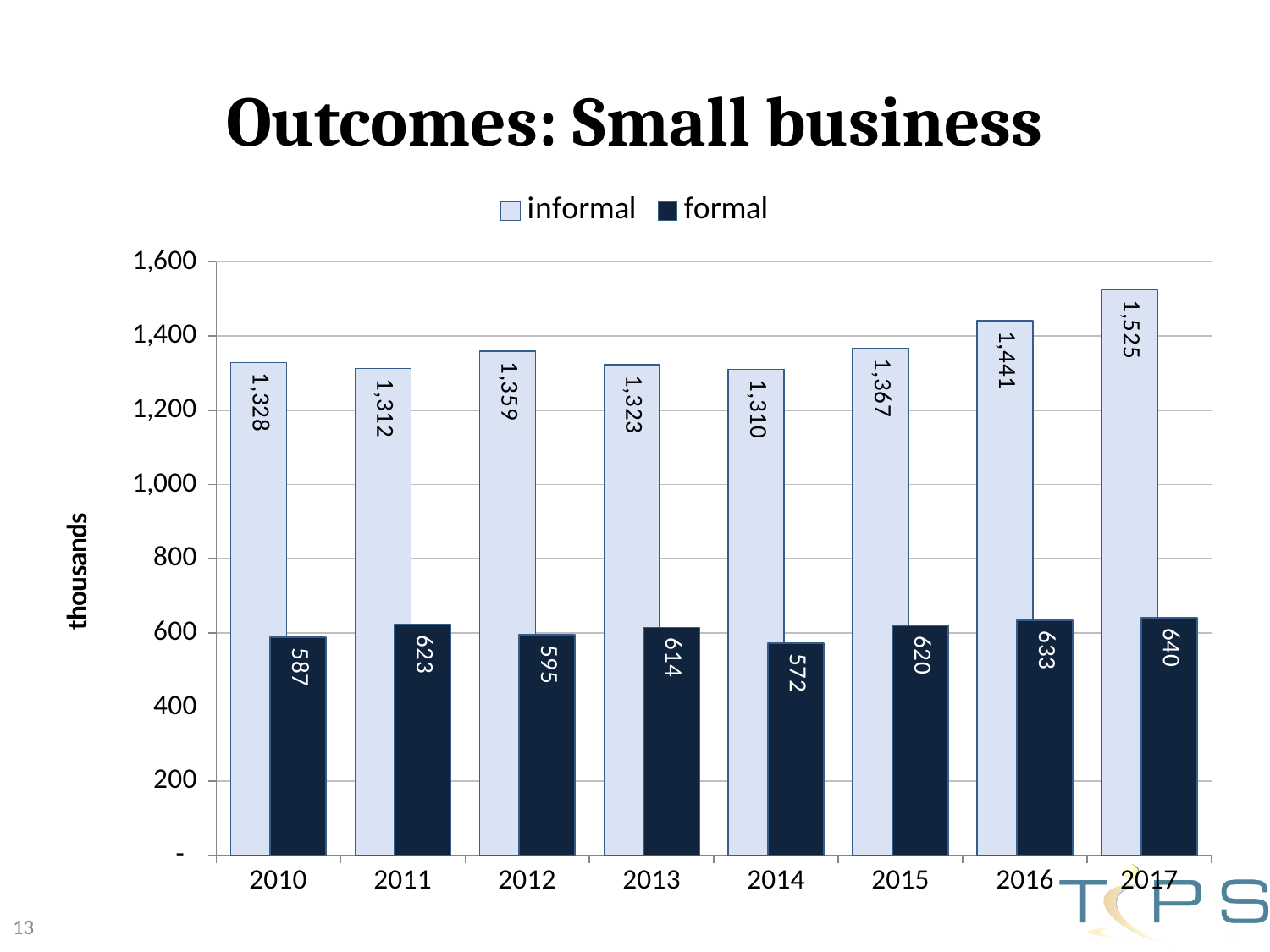
Which is larger, the formal value in 2011 or the formal value in 2013? 2011 Is the value for informal in 2016 greater or less than 1,400? greater What is the value for informal in 2010? 1,328 How many years are shown on the x axis? 8 Which year has the highest value for formal? 2017 What is the label on the vertical axis? thousands How many series does the legend list? 2 Which year has the lowest value for informal? 2014 What is the value for formal in 2014? 572 What kind of chart is shown on the slide? bar chart What is the value for informal in 2017? 1,525 What is the difference between the informal and formal values in 2016? 808